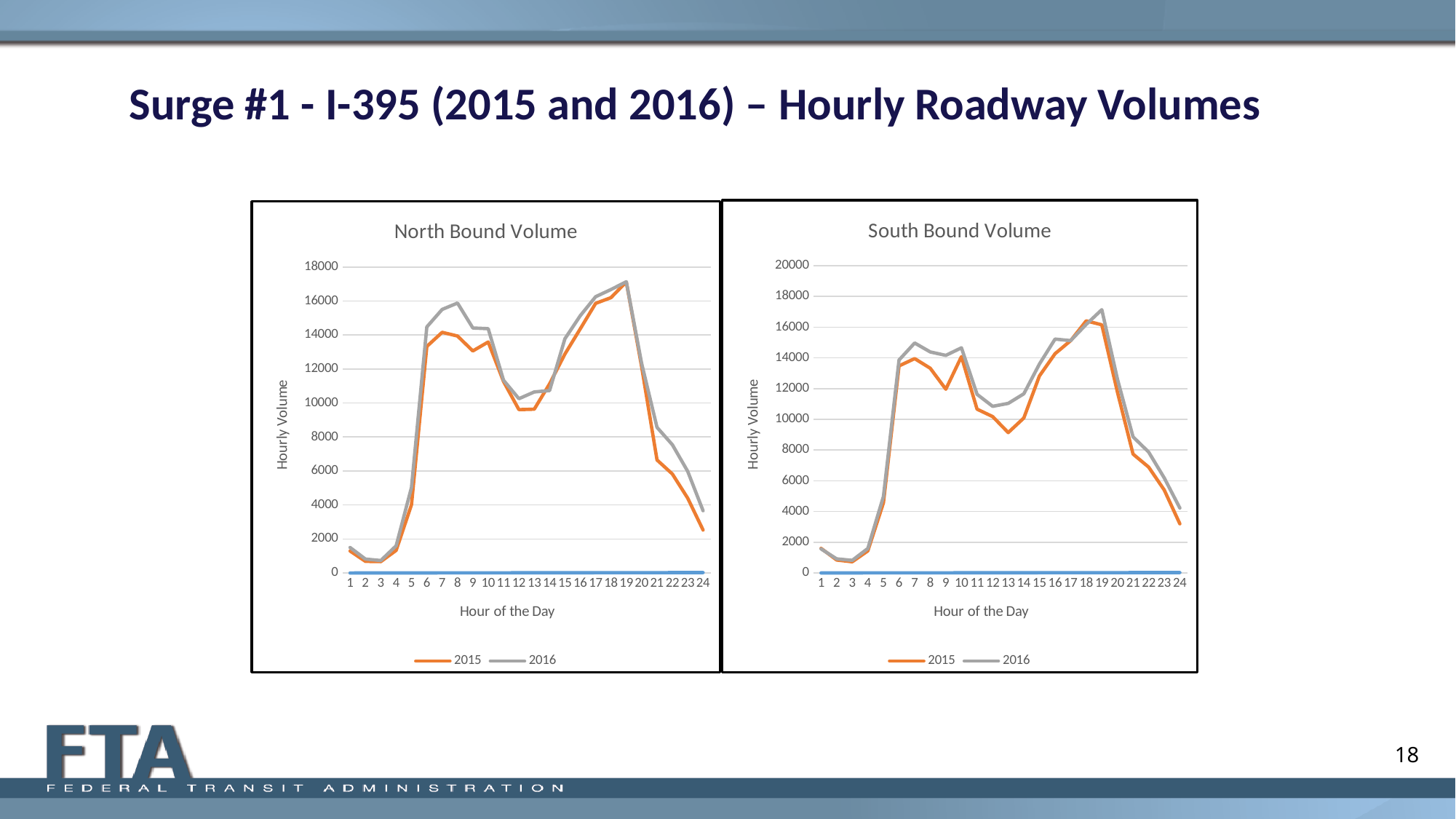
In the North Bound Volume chart, is the 2015 value at hour 24 greater or less than 4000? less How many hours of the day are plotted along the x axis of the North Bound Volume chart? 24 In the North Bound Volume chart, is the 2015 value at hour 12 greater or less than 10000? less What is the y-axis label of the South Bound Volume chart? Hourly Volume In the North Bound Volume chart, is the 2016 value at hour 8 greater or less than 14000? greater In the North Bound Volume chart, do the 2015 values rise or fall from hour 19 to hour 24? fall What type of chart is the North Bound Volume chart? line chart How many series does the legend of the South Bound Volume chart list? 2 In the North Bound Volume chart, which series has the higher value at hour 8, 2015 or 2016? 2016 In the South Bound Volume chart, which series has the higher value at hour 9, 2015 or 2016? 2016